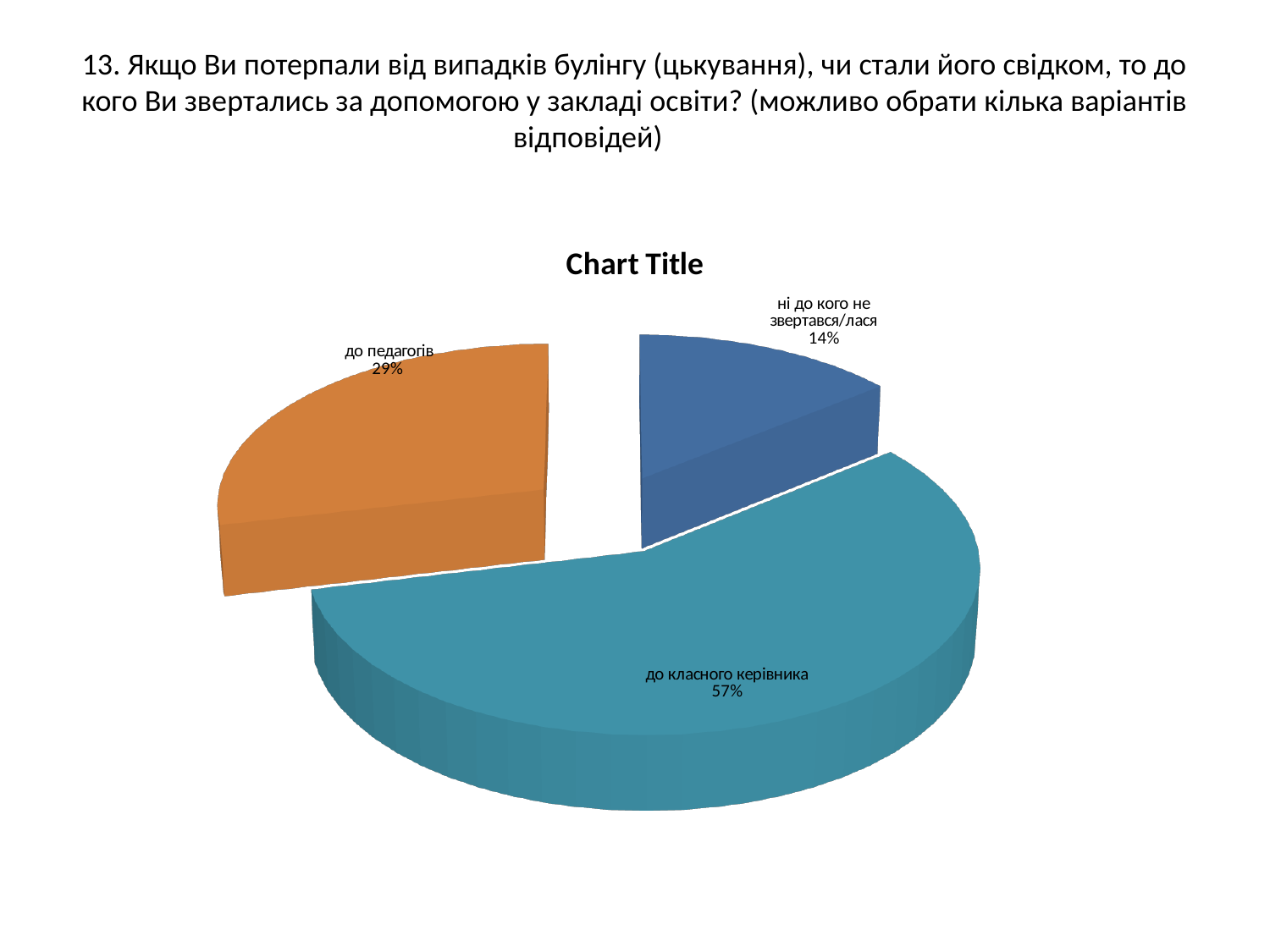
What share of the pie is labelled 'ні до кого не звертався/лася'? 14% What kind of chart is shown on the slide? pie chart What colour is the slice for 'до класного керівника'? teal What share of the pie is labelled 'до класного керівника'? 57% Which is larger: the share for 'до педагогів' or the share for 'ні до кого не звертався/лася'? до педагогів Which slice of the pie is the largest? до класного керівника What share of the pie is labelled 'до педагогів'? 29% What is the title shown above the pie chart? Chart Title How many slices does the pie chart have? 3 What is the difference in percentage points between 'до класного керівника' and 'до педагогів'? 28 What is the difference in percentage points between 'до педагогів' and 'ні до кого не звертався/лася'? 15 Which slice of the pie is the smallest? ні до кого не звертався/лася